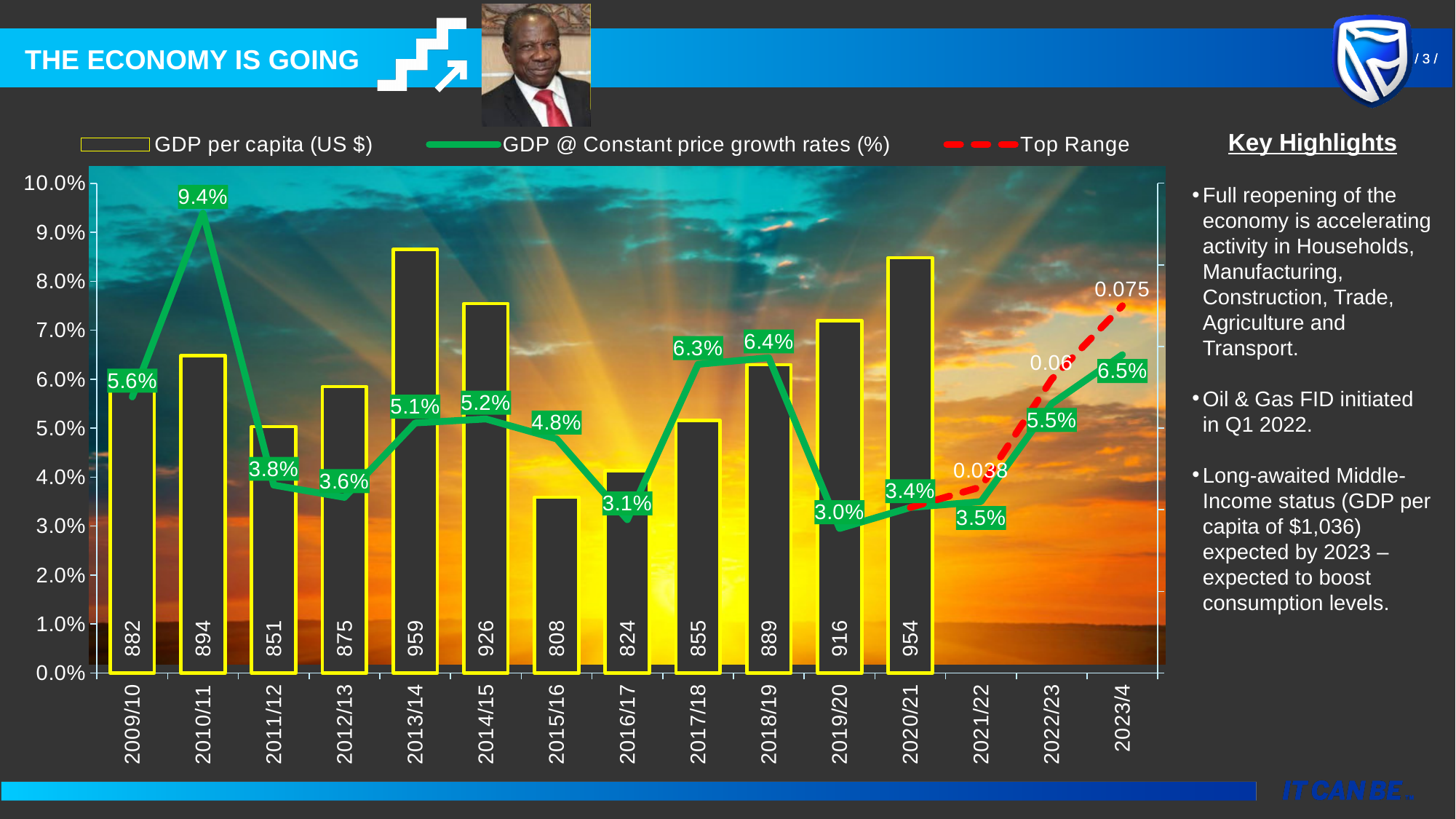
Which year has the lowest GDP @ Constant price growth rate? 2019/20 Which year has the highest GDP per capita (US $)? 2013/14 Does the GDP @ Constant price growth rate rise or fall from 2020/21 to 2023/4? rise What is the Top Range value shown for 2023/4? 0.075 How many series does the legend list? 3 Which year has the higher GDP @ Constant price growth rate, 2017/18 or 2018/19? 2018/19 What is the difference between the GDP per capita for 2013/14 and 2015/16? 151 How many years are shown on the x axis? 15 Which year has the lowest GDP per capita (US $)? 2015/16 What is the GDP per capita (US $) value for 2013/14? 959 Which legend entry is shown as a red dashed line? Top Range What is the GDP @ Constant price growth rate for 2010/11? 9.4%